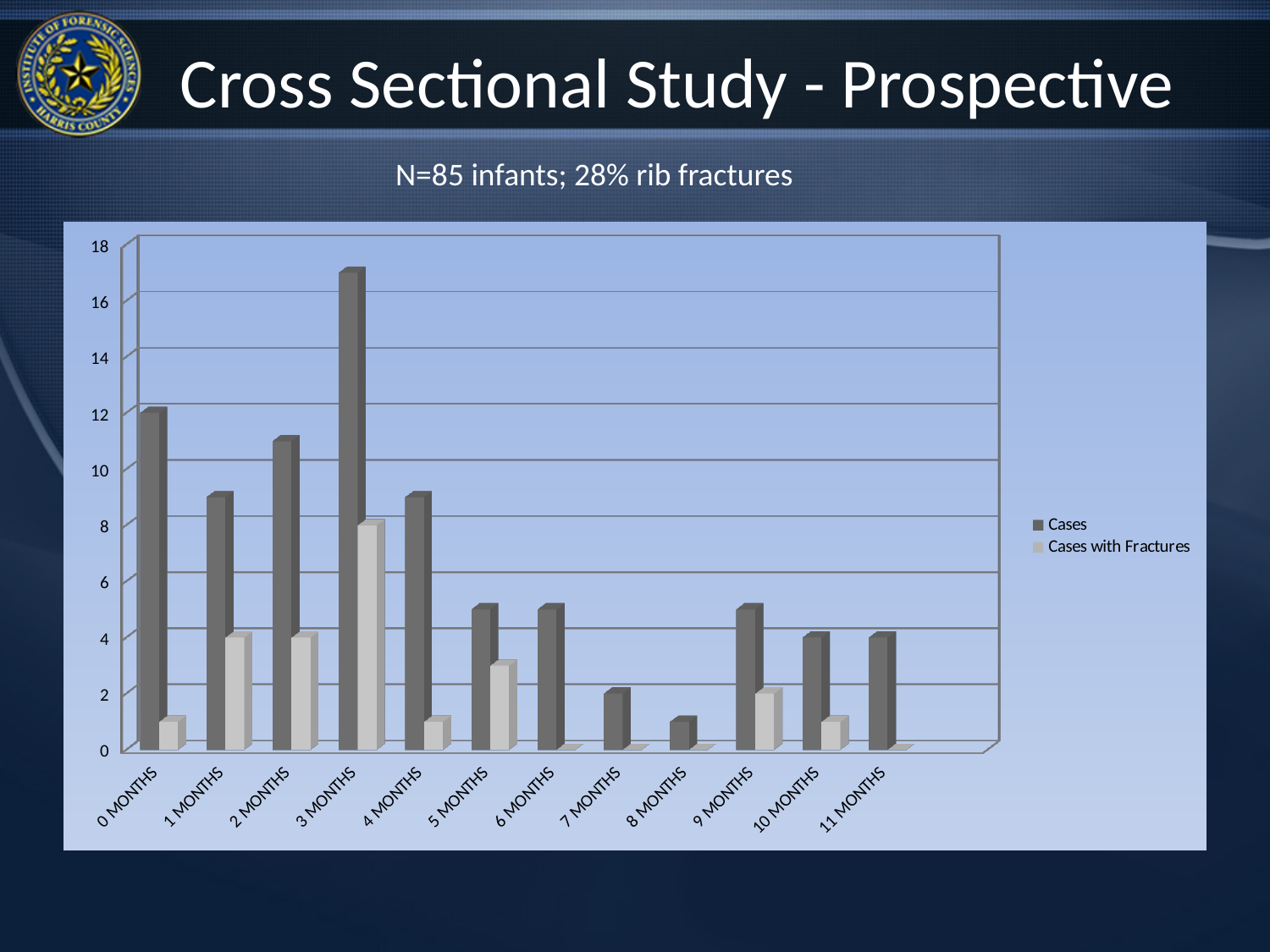
Which has more Cases, 0 MONTHS or 1 MONTHS? 0 MONTHS What are the two series named in the legend? Cases; Cases with Fractures Is the value for Cases with Fractures at 3 MONTHS greater or less than 6? greater Which month category has the highest number of Cases with Fractures? 3 MONTHS Is the value for Cases at 0 MONTHS greater or less than 10? greater How many month categories are shown on the x axis? 12 Which month category has the lowest number of Cases? 8 MONTHS Which month category has the highest number of Cases? 3 MONTHS What kind of chart is shown on the slide? Bar chart How many series does the legend list? 2 Is the value for Cases at 7 MONTHS greater or less than 4? less